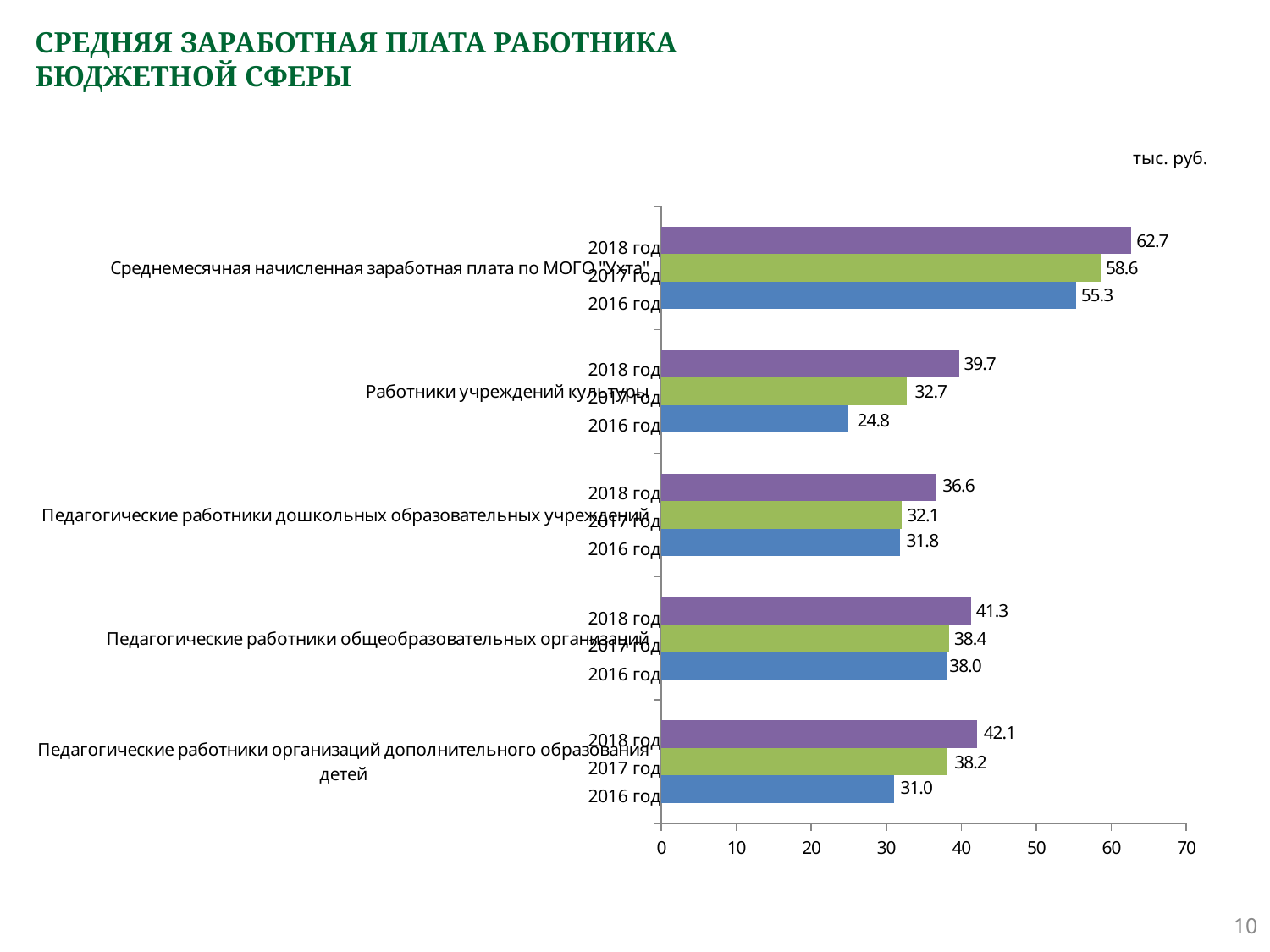
Which year has the highest value for "Педагогические работники общеобразовательных организаций"? 2018 год What is the difference between the 2018 год and 2016 год values for "Работники учреждений культуры"? 14.9 Do the values for "Педагогические работники организаций дополнительного образования детей" rise or fall from 2016 год to 2018 год? Rise What is the value for 2018 год for "Педагогические работники организаций дополнительного образования детей"? 42.1 Which year has the lowest value for "Работники учреждений культуры"? 2016 год What type of chart is shown on the slide? Bar chart How many categories of workers are shown on the chart? 5 What is the value for 2016 год for "Работники учреждений культуры"? 24.8 What is the value for 2017 год for "Педагогические работники дошкольных образовательных учреждений"? 32.1 Which is larger: the 2018 год value for "Педагогические работники общеобразовательных организаций" or the 2018 год value for "Педагогические работники дошкольных образовательных учреждений"? Педагогические работники общеобразовательных организаций What unit of measurement is indicated on the slide for the chart values? тыс. руб. What is the value for 2018 год for "Среднемесячная начисленная заработная плата по МОГО "Ухта""? 62.7